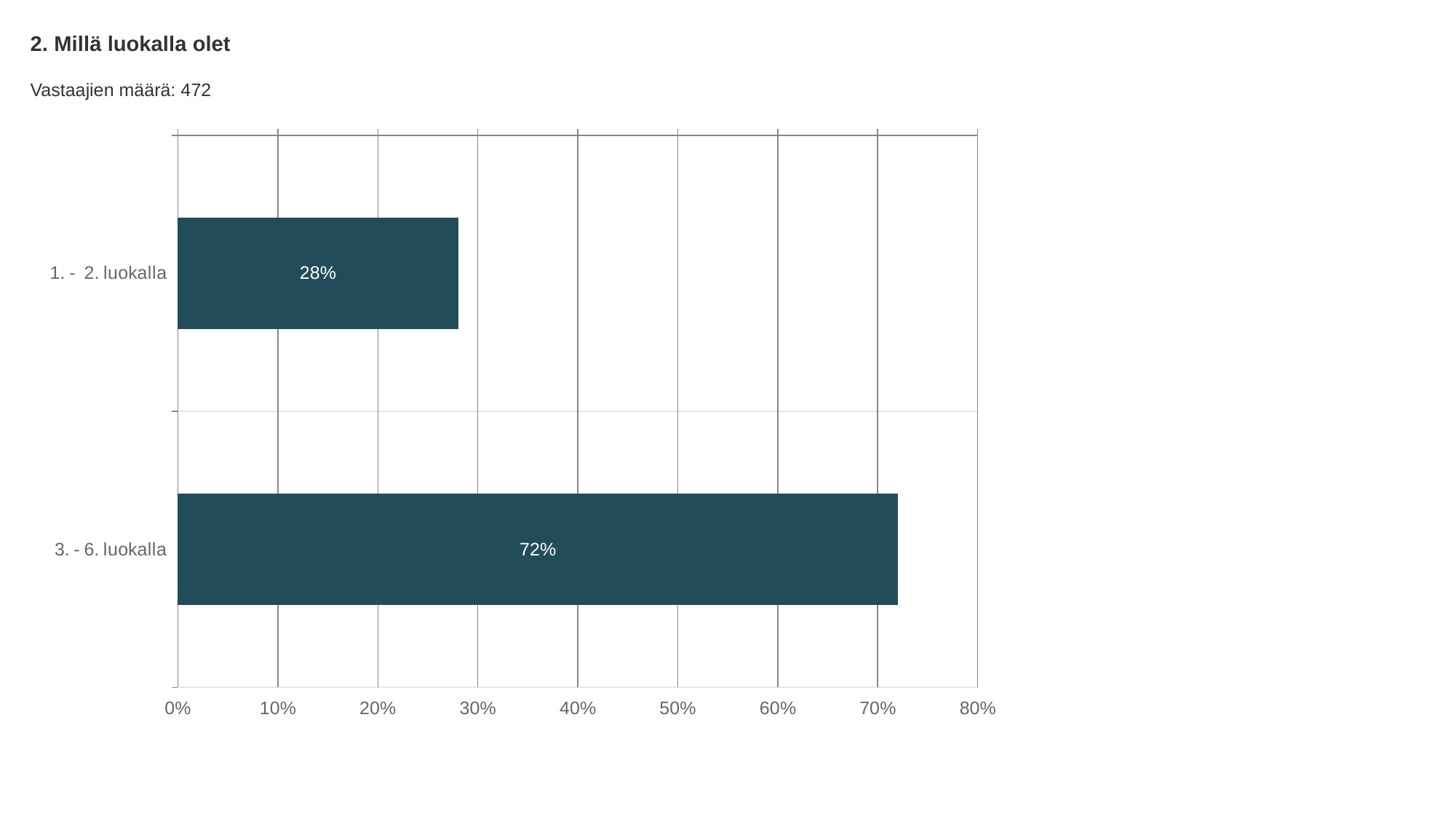
Which category has the highest value? 3. - 6. luokalla Is the value for "3. - 6. luokalla" greater or less than 50%? greater What is the value for "1. - 2. luokalla"? 28% How many categories are shown in the chart? 2 How many respondents (Vastaajien määrä) are reported on the slide? 472 What is the title of the chart? 2. Millä luokalla olet What is the difference between the values for "3. - 6. luokalla" and "1. - 2. luokalla"? 44% Which is larger, the value for "1. - 2. luokalla" or the value for "3. - 6. luokalla"? 3. - 6. luokalla What is the value for "3. - 6. luokalla"? 72% What kind of chart is shown on the slide? bar chart Which category has the lowest value? 1. - 2. luokalla Is the value for "1. - 2. luokalla" greater or less than 30%? less